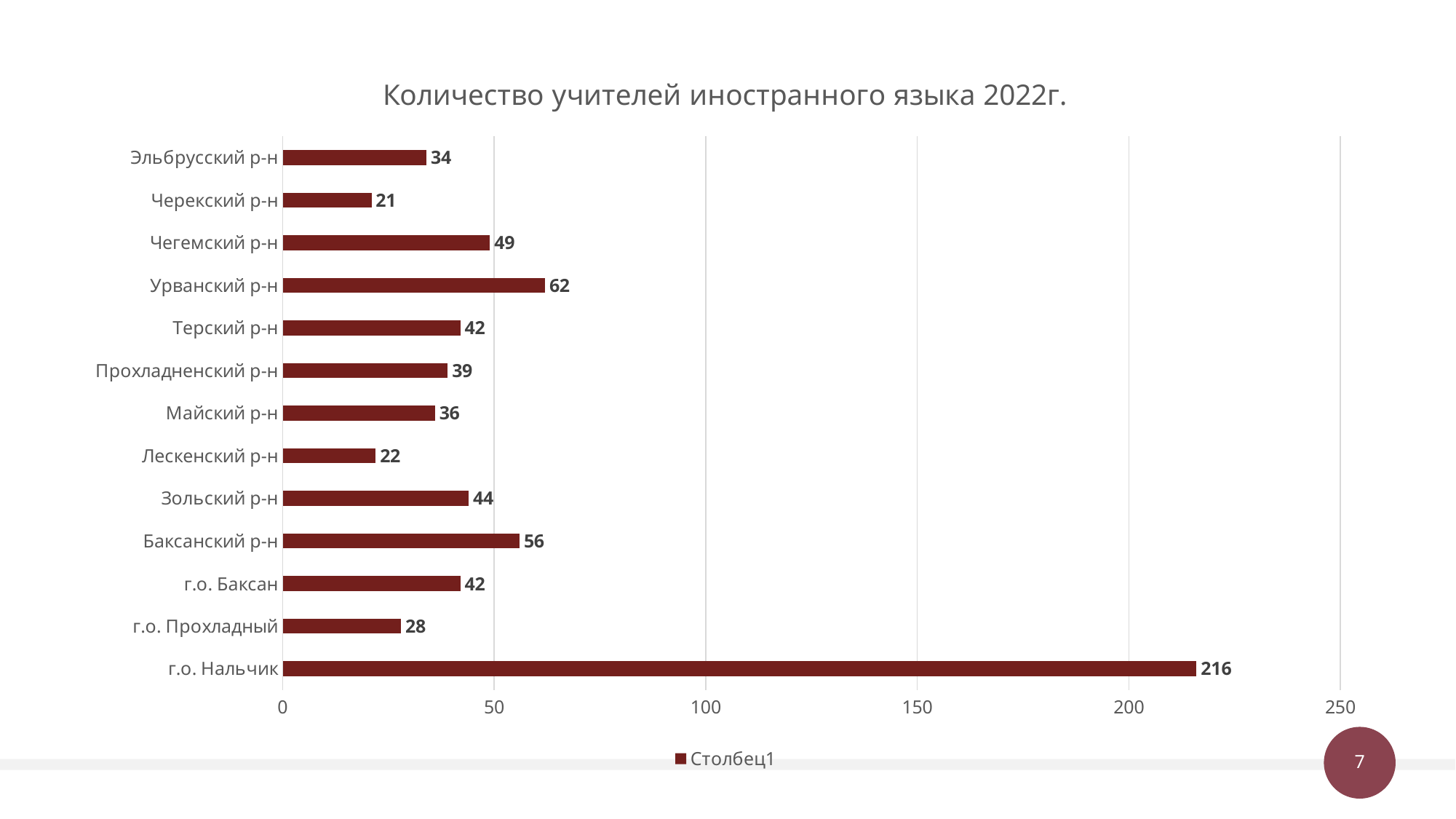
Which category has the highest value? г.о. Нальчик Which is larger, the value for Чегемский р-н or the value for Зольский р-н? Чегемский р-н What is the value for г.о. Нальчик? 216 How many series does the legend list? 1 What is the value for Урванский р-н? 62 Which category has the lowest value? Черекский р-н What kind of chart is shown on the slide? bar chart What is the title of the chart? Количество учителей иностранного языка 2022г. Is the value for г.о. Нальчик greater or less than 200? greater What is the difference between the values for г.о. Нальчик and Баксанский р-н? 160 How many categories are shown on the chart? 13 What is the value for Черекский р-н? 21